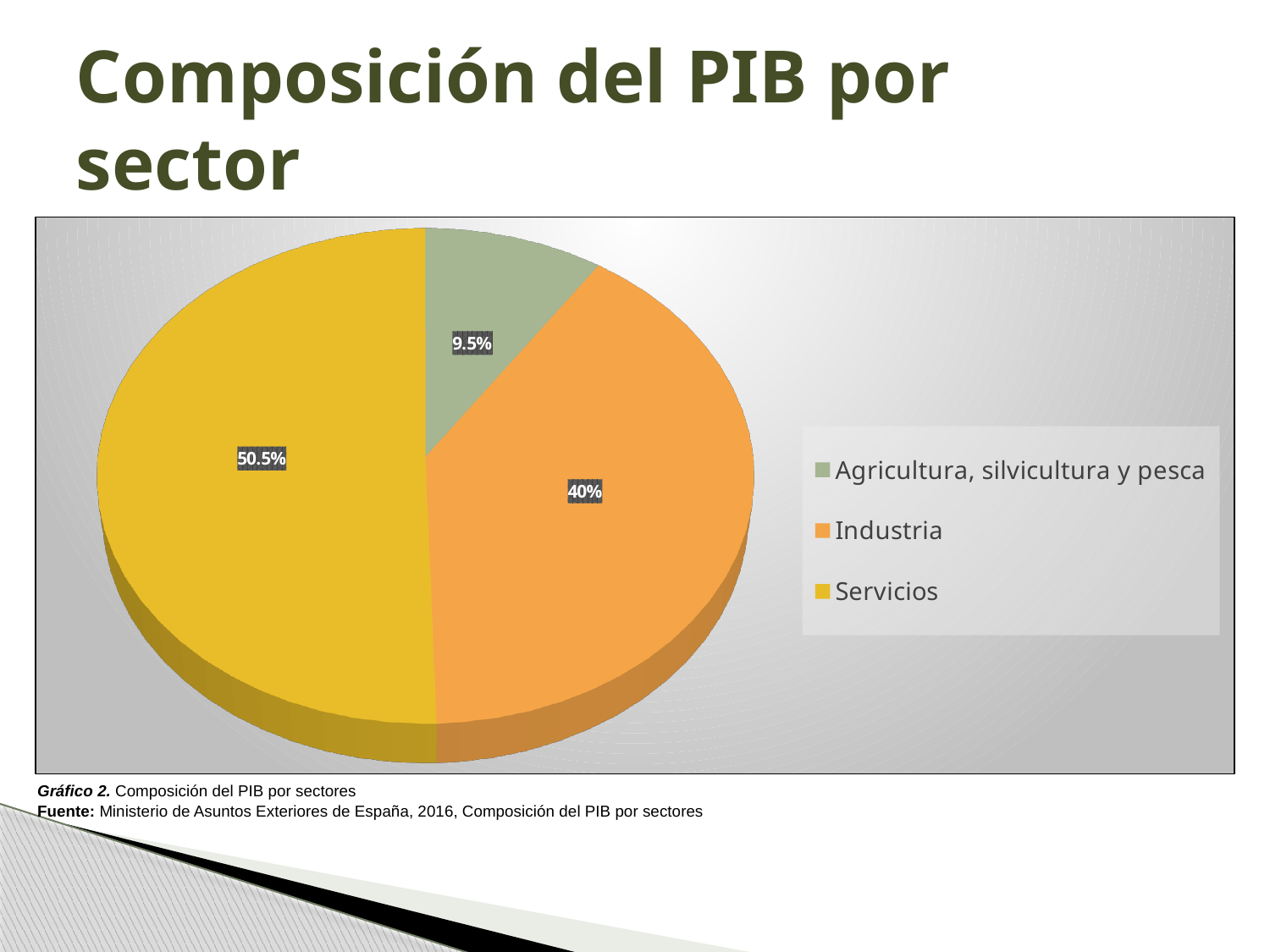
How many sectors are shown in the pie chart? 3 Which sector has the smallest slice of the pie? Agricultura, silvicultura y pesca What is the difference between the Industria and Agricultura, silvicultura y pesca shares? 30.5% What is the difference between the Servicios and Industria shares? 10.5% What kind of chart is shown on the slide? Pie chart What is the value shown for Agricultura, silvicultura y pesca? 9.5% What colour is the Servicios slice? Yellow What is the value shown for Industria? 40% What share of the pie does Servicios represent? 50.5% Which sector has the largest slice of the pie? Servicios What is the title of the slide? Composición del PIB por sector Which is larger, the share for Industria or the share for Agricultura, silvicultura y pesca? Industria